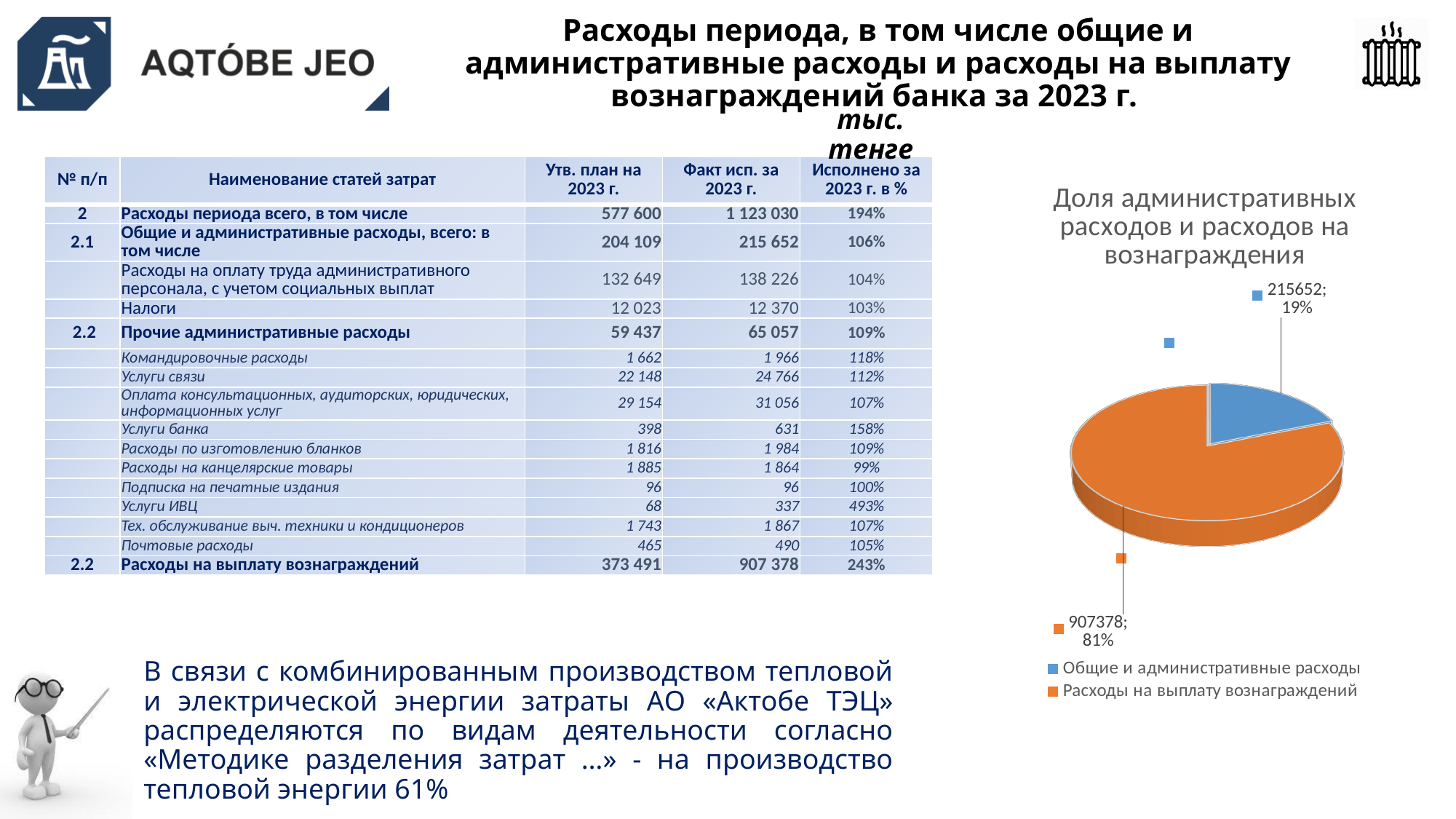
What share of the pie does Общие и административные расходы take? 19% In the pie chart, what value is labelled for Общие и административные расходы? 215652 How many entries does the legend of the pie chart list? 2 How many slices does the pie chart have? 2 What is the title of the pie chart? Доля административных расходов и расходов на вознаграждения In the pie chart, what is the difference between the value for Расходы на выплату вознаграждений and the value for Общие и административные расходы? 691726 Which slice of the pie chart is the largest? Расходы на выплату вознаграждений In the pie chart, what value is labelled for Расходы на выплату вознаграждений? 907378 Which slice of the pie chart is the smallest? Общие и административные расходы What share of the pie does Расходы на выплату вознаграждений take? 81% What kind of chart is shown on the right side of the slide? pie chart What colour is the slice for Расходы на выплату вознаграждений in the pie chart? orange